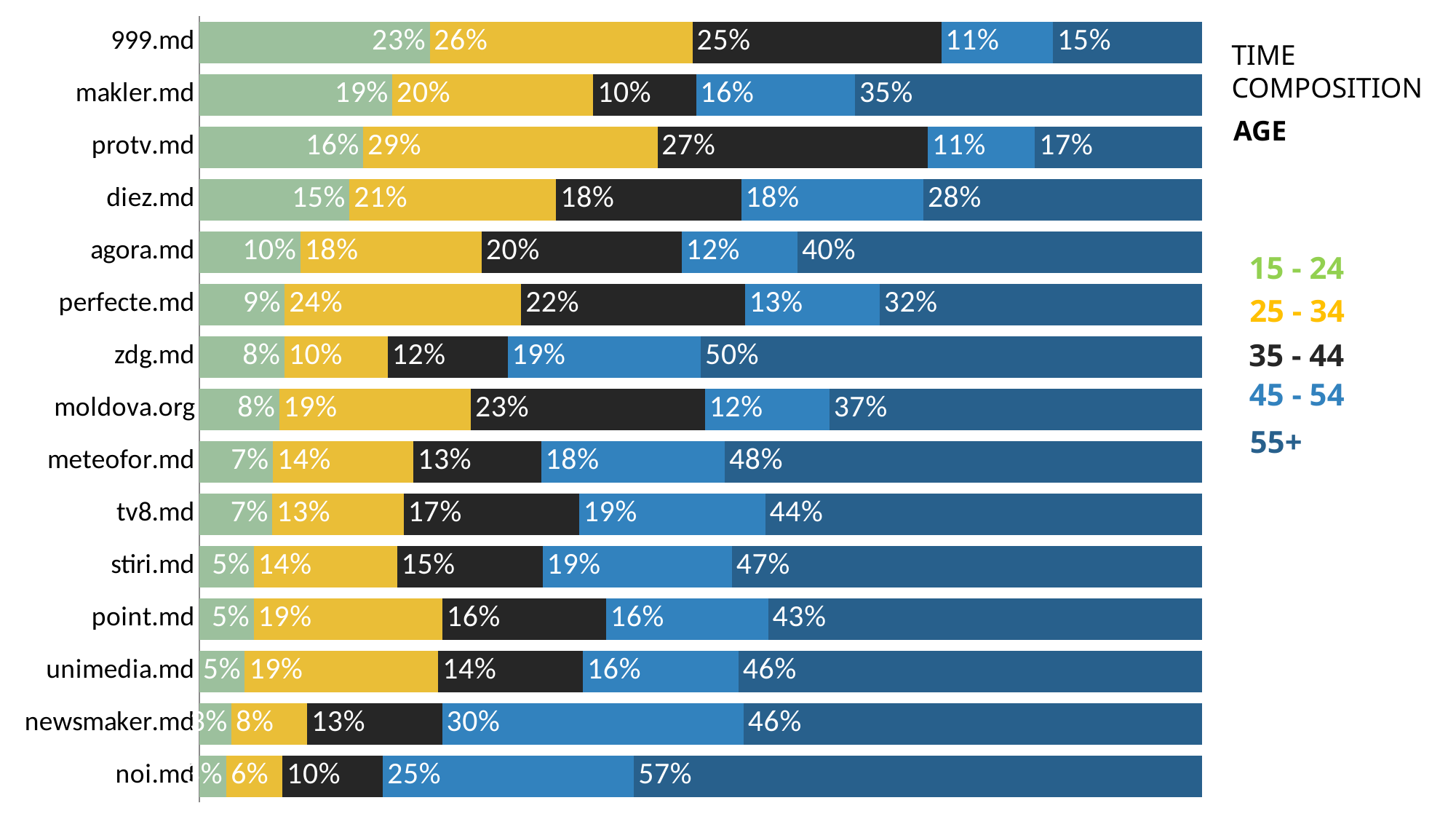
How many age groups does the legend list? 5 What is the 25 - 34 share for protv.md? 29% Which website has the lowest 55+ share? 999.md For 999.md, how much larger is the 25 - 34 share than the 45 - 54 share? 15 percentage points Which website has the highest 15 - 24 share? 999.md What percentage of zdg.md's audience is in the 55+ age group? 50% What kind of chart is shown on the slide? Stacked bar chart What is the 45 - 54 share for newsmaker.md? 30% Which website has the highest 55+ share? noi.md Which has a larger 55+ share, makler.md or diez.md? makler.md What colour represents the 35 - 44 age group? Black How many websites are listed in the chart? 15